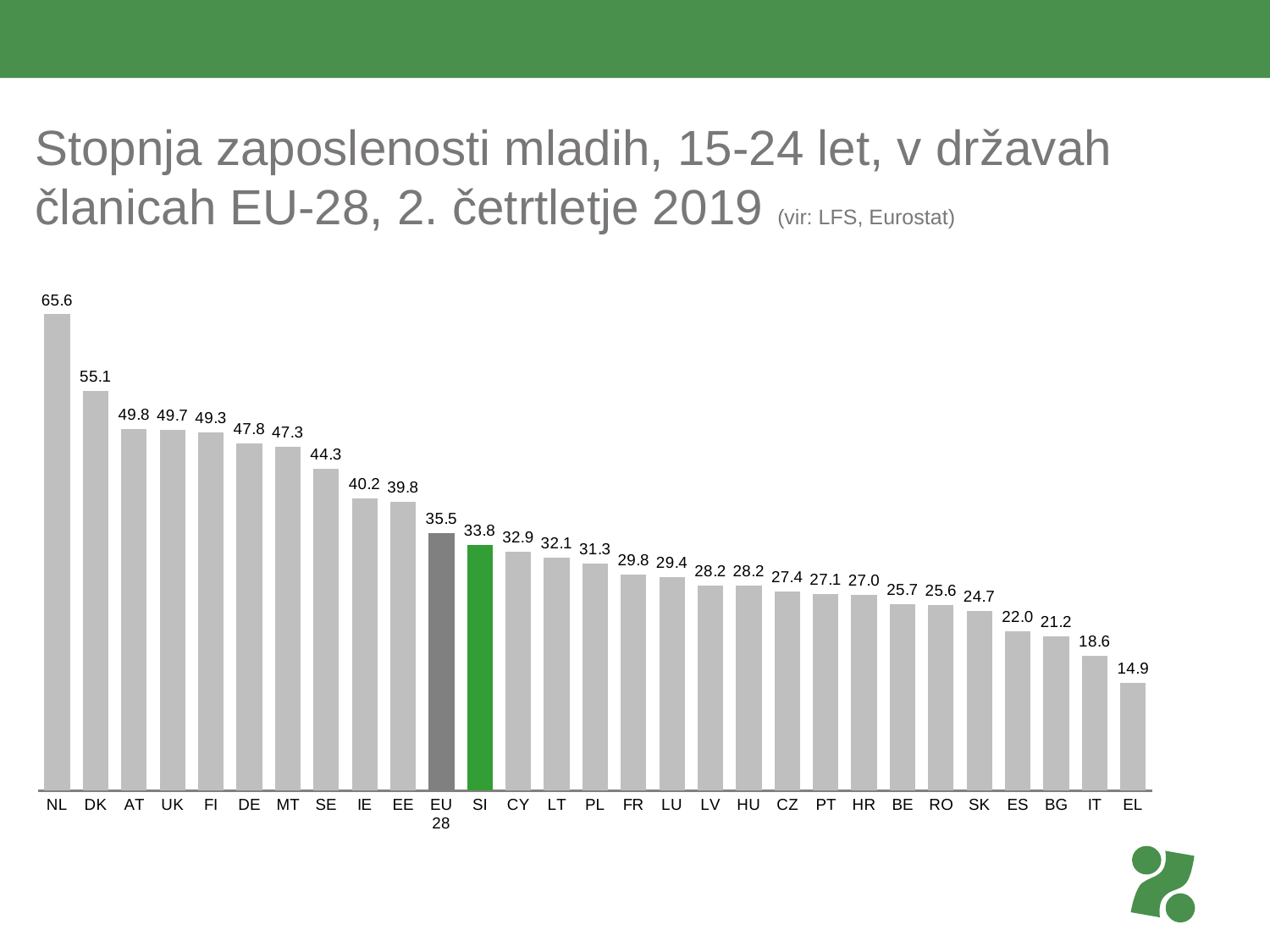
What is the value for NL? 65.6 What is the value for EL? 14.9 Which category has the highest value? NL What kind of chart is shown on the slide? Bar chart Which is larger, the value for IE or the value for PL? IE What is the difference between the values for EU 28 and SI? 1.7 How many bars are shown in the chart? 29 What is the value for SI? 33.8 What is the value for EU 28? 35.5 Which bar is coloured green? SI What is the difference between the values for NL and DK? 10.5 Which category has the lowest value? EL